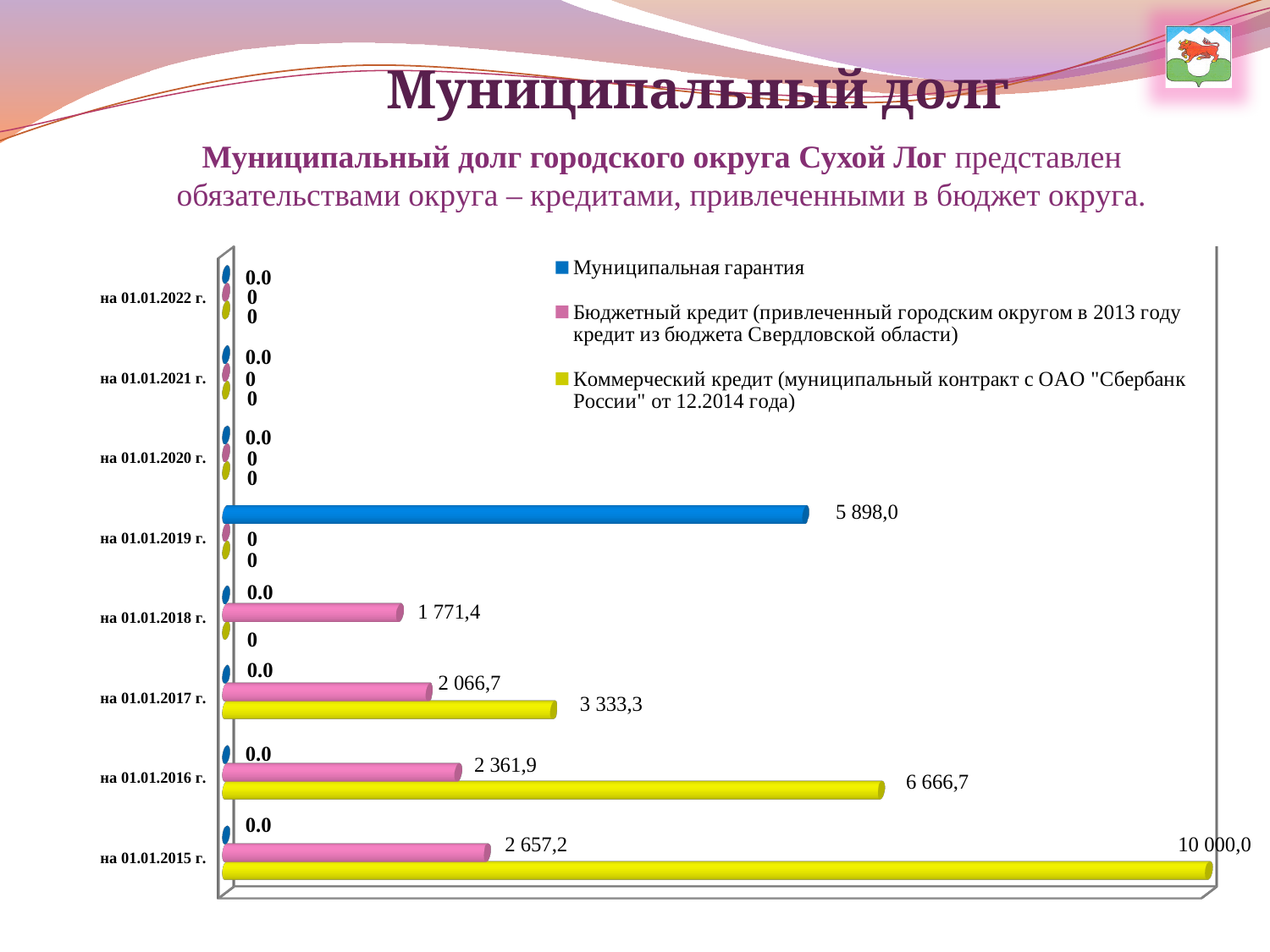
What is the difference between Коммерческий кредит на 01.01.2016 г. and на 01.01.2017 г.? 3 333,4 Which colour represents Муниципальная гарантия in the chart? blue What is the value of Муниципальная гарантия на 01.01.2019 г.? 5 898,0 What is the value of Бюджетный кредит на 01.01.2018 г.? 1 771,4 How many date categories are shown on the chart? 8 What is the value of Коммерческий кредит на 01.01.2015 г.? 10 000,0 How many series does the chart legend list? 3 Which is larger на 01.01.2017 г.: Бюджетный кредит or Коммерческий кредит? Коммерческий кредит For which date is the Бюджетный кредит value highest? на 01.01.2015 г. Does the Бюджетный кредит value rise or fall from 01.01.2015 to 01.01.2018? fall What type of chart is shown on the slide? bar chart What is the value of Коммерческий кредит на 01.01.2016 г.? 6 666,7